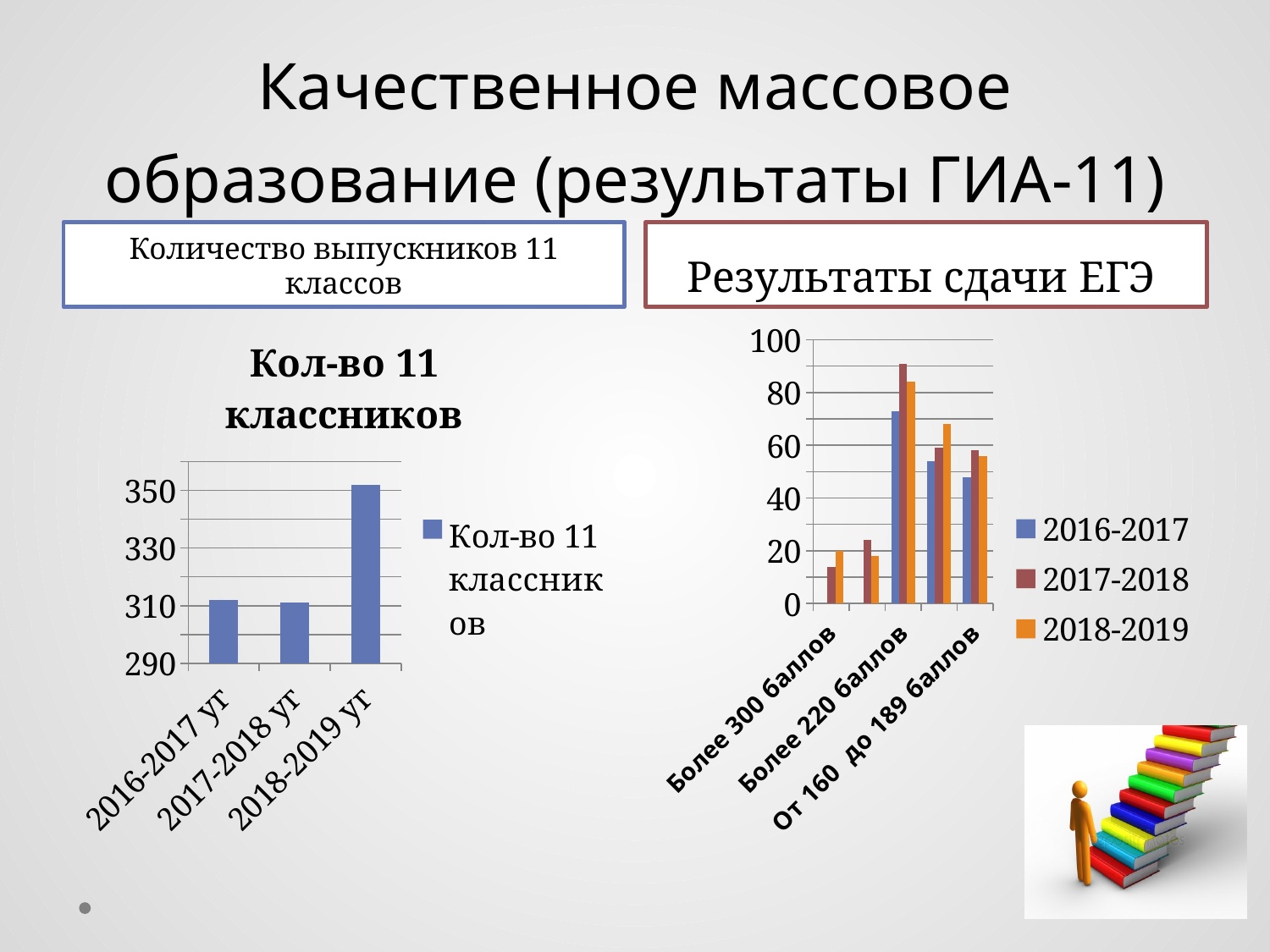
On the chart titled "Кол-во 11 классников", is the value for 2018-2019 уг greater or less than 330? greater On the chart under the heading "Результаты сдачи ЕГЭ", for the category "Более 220 баллов", which is larger: the 2016-2017 value or the 2017-2018 value? 2017-2018 On the chart titled "Кол-во 11 классников", which category has the highest value? 2018-2019 уг On the chart titled "Кол-во 11 классников", how many categories are shown on the x axis? 3 On the chart titled "Кол-во 11 классников", is the value for 2016-2017 уг greater or less than 330? less On the chart under the heading "Результаты сдачи ЕГЭ", what are the three series listed in the legend? 2016-2017, 2017-2018, 2018-2019 What kind of chart is the chart titled "Кол-во 11 классников"? bar chart On the chart under the heading "Результаты сдачи ЕГЭ", is the 2017-2018 value for "Более 220 баллов" greater or less than 80? greater On the chart under the heading "Результаты сдачи ЕГЭ", which category has the highest value for the 2017-2018 series? Более 220 баллов On the chart under the heading "Результаты сдачи ЕГЭ", how many series does the legend list? 3